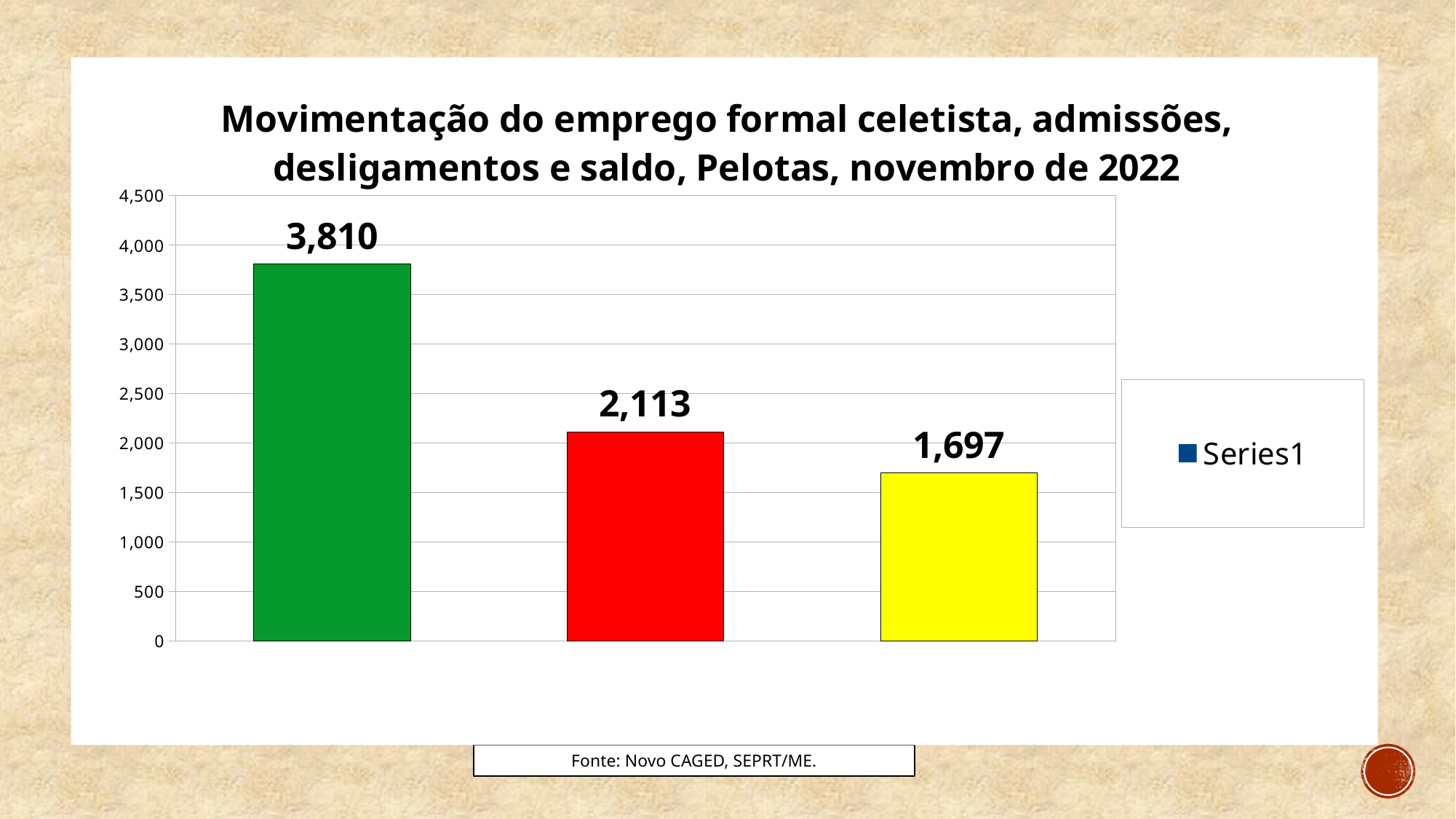
What value is shown on the red (middle) bar? 2,113 Which bar has the highest value? The green (first) bar, 3,810 What series name does the legend list? Series1 What type of chart is shown on the slide? Bar chart What value is shown on the green (first) bar? 3,810 Which bar has the lowest value? The yellow (third) bar, 1,697 How many bars are plotted in the chart? 3 Which is larger, the value of the red bar or the value of the yellow bar? The red bar (2,113) What is the difference between the green bar (3,810) and the red bar (2,113)? 1,697 What value is shown on the yellow (third) bar? 1,697 Is the value of the green bar greater or less than 3,500? greater What is the difference between the red bar (2,113) and the yellow bar (1,697)? 416